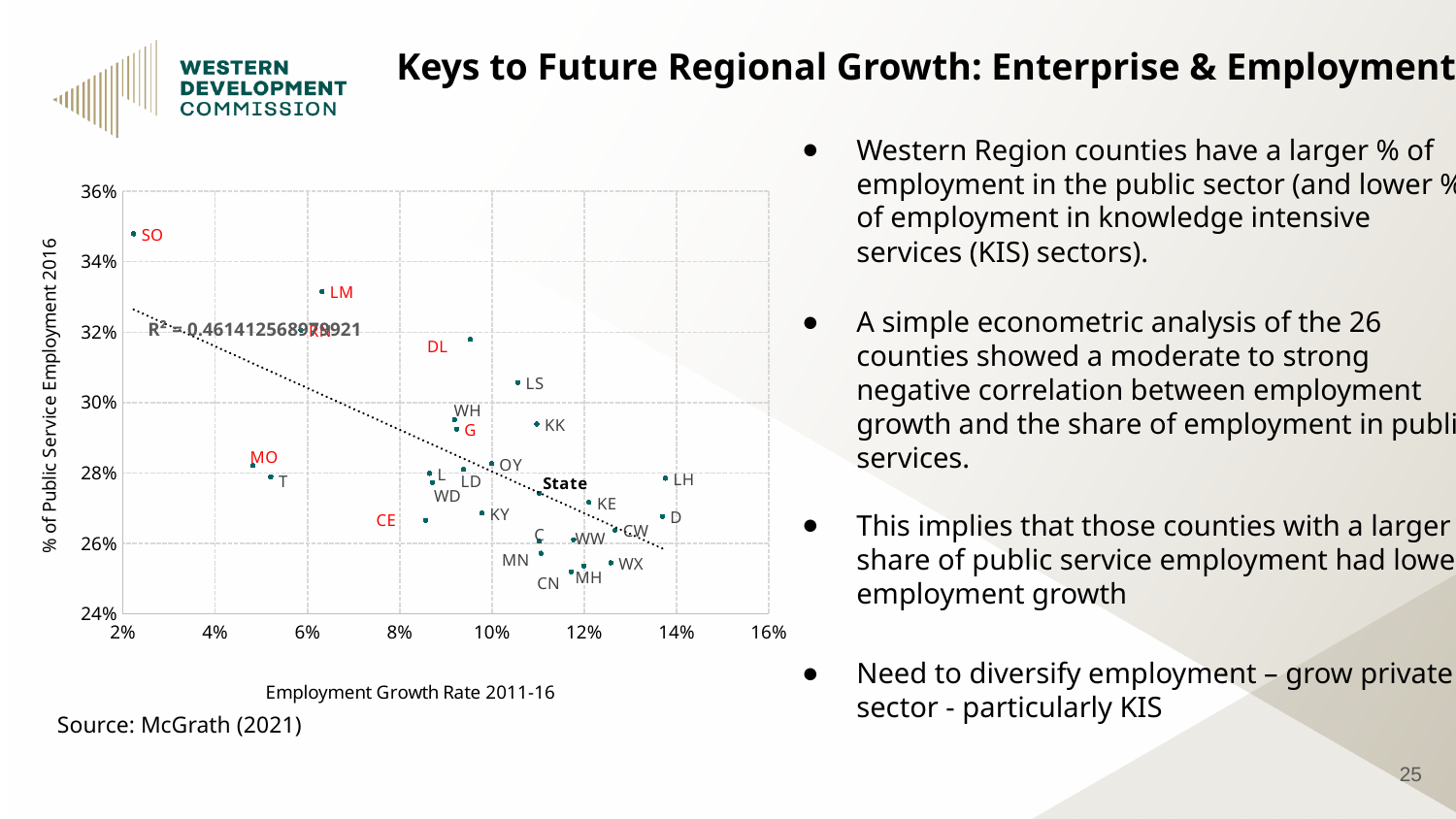
Is the % of public service employment for SO greater or less than 34%? greater What kind of chart is shown on the slide? scatter plot What is the title of the x axis of the chart? Employment Growth Rate 2011-16 Which county has the highest % of public service employment in the chart? SO Is the % of public service employment for LM greater or less than 32%? greater What is the title of the y axis of the chart? % of Public Service Employment 2016 As the employment growth rate increases along the x axis, does the % of public service employment generally rise or fall? fall Which has a higher % of public service employment, LM or DL? LM Is the % of public service employment for CE greater or less than 28%? less Which county has the lowest employment growth rate in the chart? SO